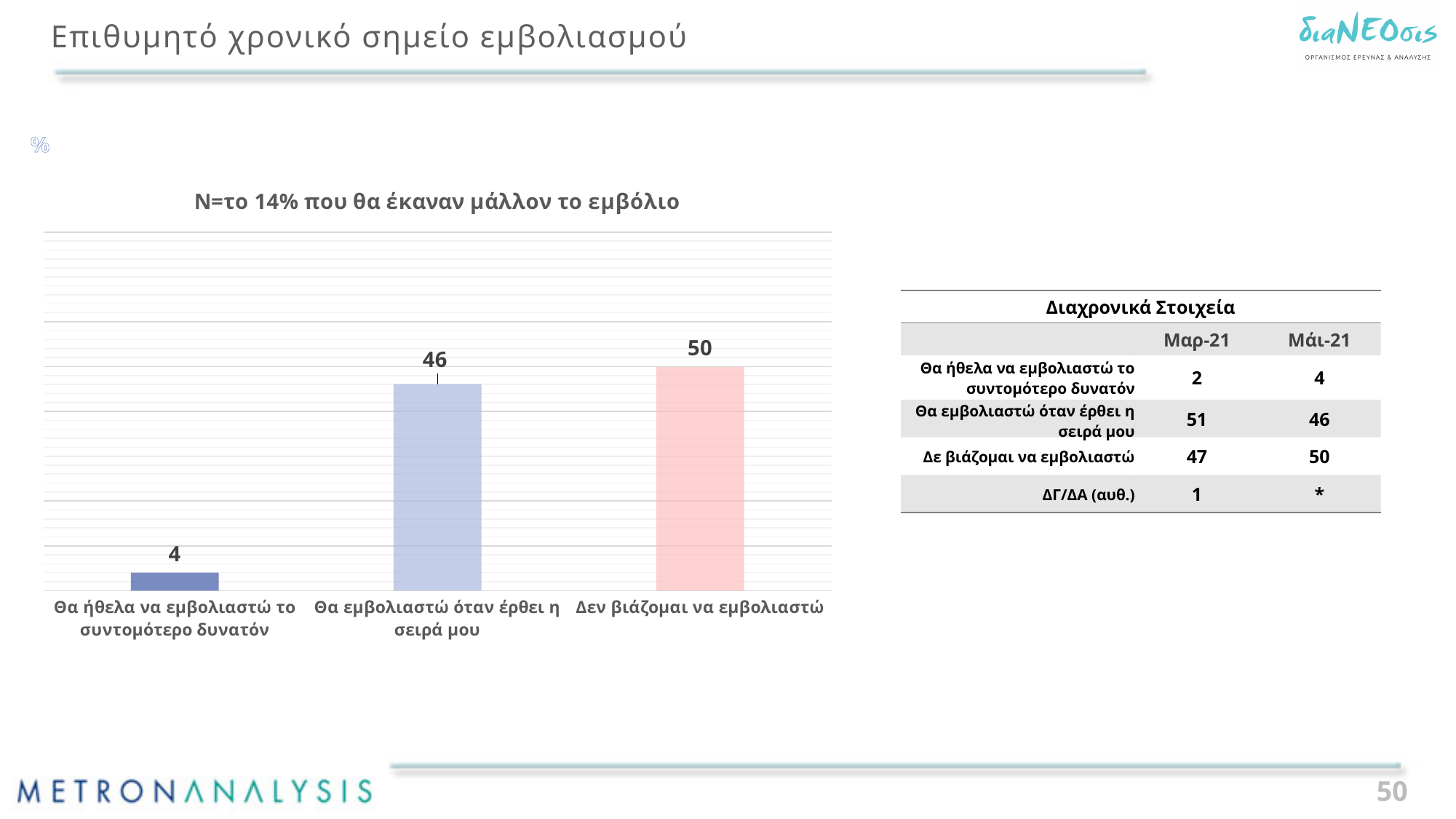
Which category has the lowest value? Θα ήθελα να εμβολιαστώ το συντομότερο δυνατόν What value is shown for "Δεν βιάζομαι να εμβολιαστώ"? 50 How many categories are shown in the bar chart? 3 What value is shown for "Θα εμβολιαστώ όταν έρθει η σειρά μου"? 46 What value is shown for "Θα ήθελα να εμβολιαστώ το συντομότερο δυνατόν"? 4 What is the difference between the values for "Θα εμβολιαστώ όταν έρθει η σειρά μου" and "Θα ήθελα να εμβολιαστώ το συντομότερο δυνατόν"? 42 Which is larger: the value for "Θα εμβολιαστώ όταν έρθει η σειρά μου" or the value for "Θα ήθελα να εμβολιαστώ το συντομότερο δυνατόν"? Θα εμβολιαστώ όταν έρθει η σειρά μου What is the title of the chart? N=το 14% που θα έκαναν μάλλον το εμβόλιο Do the values rise or fall from left to right across the categories? Rise Which category has the highest value? Δεν βιάζομαι να εμβολιαστώ What is the difference between the values for "Δεν βιάζομαι να εμβολιαστώ" and "Θα εμβολιαστώ όταν έρθει η σειρά μου"? 4 What kind of chart is shown on the slide? Bar chart